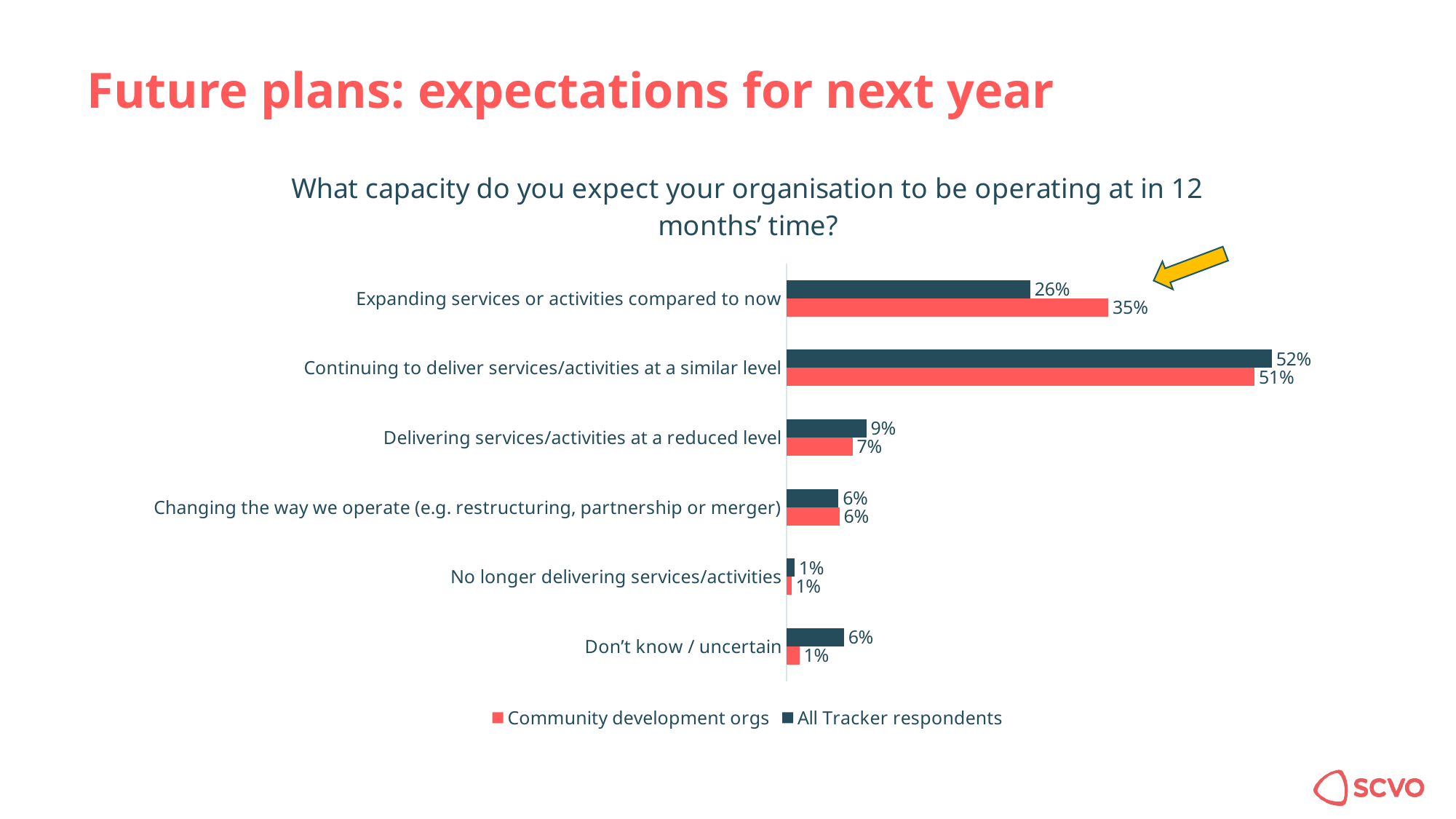
What is the value for All Tracker respondents for 'Continuing to deliver services/activities at a similar level'? 52% What percentage of All Tracker respondents expect to be expanding services or activities compared to now? 26% How many categories are shown on the chart? 6 What is the value for Community development orgs for 'Don't know / uncertain'? 1% What type of chart is shown on the slide? Bar chart What percentage of Community development orgs expect to be expanding services or activities compared to now? 35% What is the difference between Community development orgs and All Tracker respondents for 'Expanding services or activities compared to now'? 9 percentage points Which category has the lowest value for All Tracker respondents? No longer delivering services/activities How many series does the legend list? 2 Which category has the highest value for Community development orgs? Continuing to deliver services/activities at a similar level Which colour represents Community development orgs in the chart? Red For 'Delivering services/activities at a reduced level', which series has the larger value? All Tracker respondents